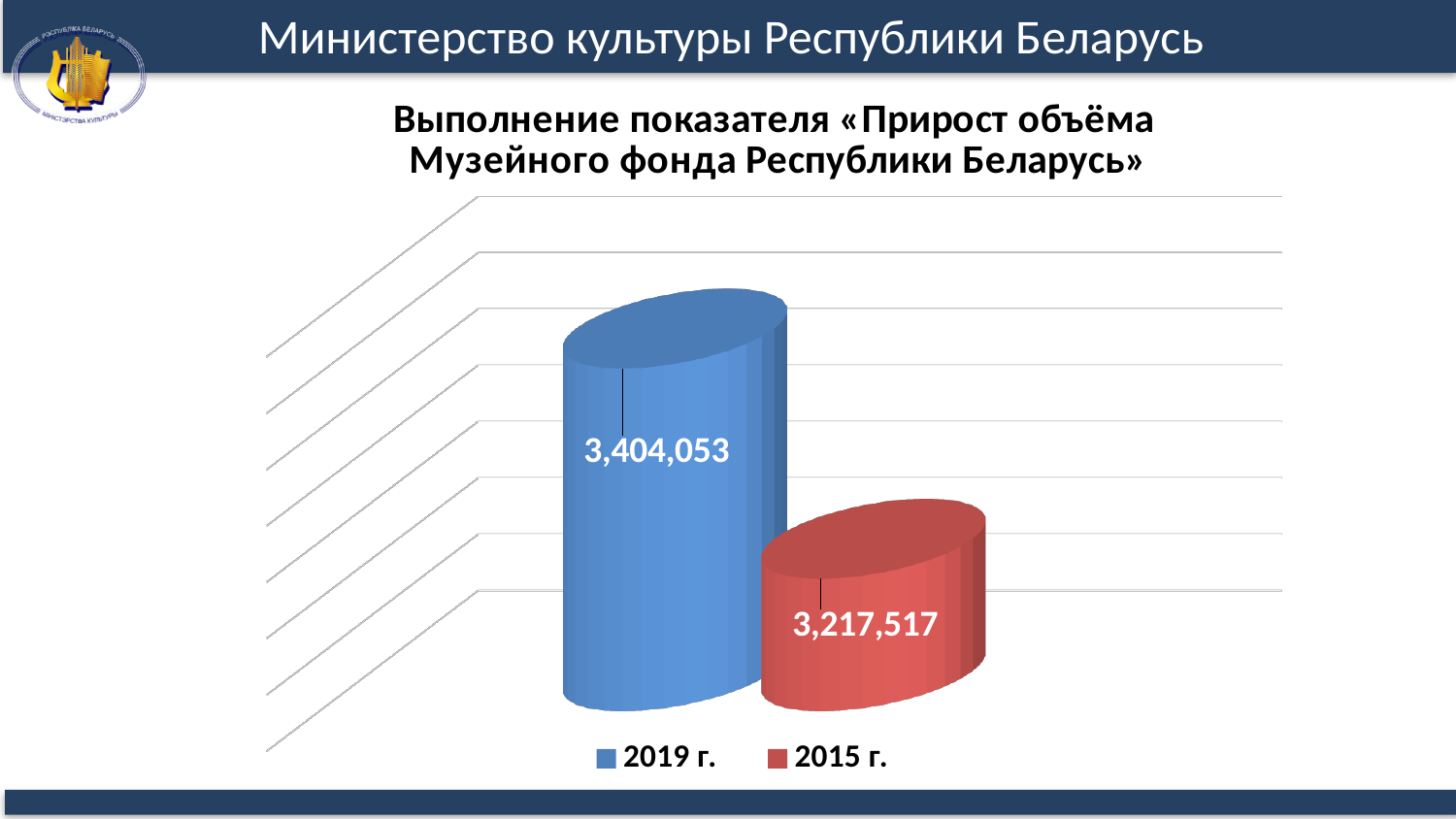
Which series has the lowest value? 2015 г. How many bars are plotted on the chart? 2 What kind of chart is shown on the slide? Bar chart What is the value shown for 2019 г.? 3,404,053 What colour is the bar for 2015 г.? Red Which is larger, the value for 2019 г. or the value for 2015 г.? 2019 г. Which series has the highest value? 2019 г. What is the value shown for 2015 г.? 3,217,517 What is the difference between the 2019 г. value and the 2015 г. value? 186,536 How many series does the legend list? 2 What is the title of the chart? Выполнение показателя «Прирост объёма Музейного фонда Республики Беларусь»